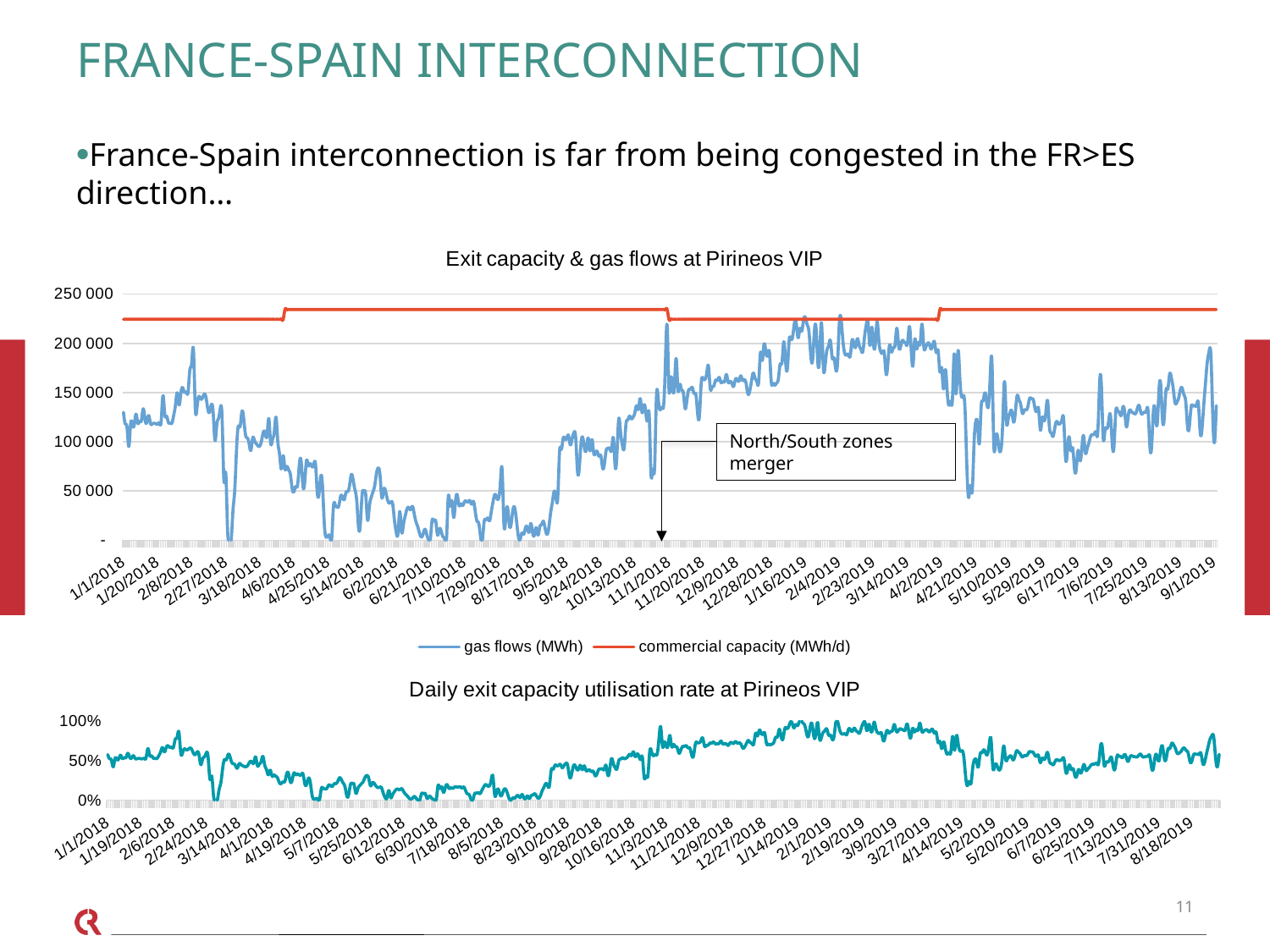
In the top chart "Exit capacity & gas flows at Pirineos VIP", do the gas flows (MWh) rise or fall between 9/5/2018 and 1/16/2019? rise In the bottom chart "Daily exit capacity utilisation rate at Pirineos VIP", is the utilisation rate around 6/12/2018 greater or less than 50%? less In the top chart "Exit capacity & gas flows at Pirineos VIP", is the commercial capacity (MWh/d) greater or less than 200 000 throughout the period? greater What kind of chart is the bottom chart titled "Daily exit capacity utilisation rate at Pirineos VIP"? Line chart How many series does the legend of the top chart "Exit capacity & gas flows at Pirineos VIP" list? 2 In the top chart "Exit capacity & gas flows at Pirineos VIP", are the gas flows (MWh) around 6/21/2018 greater or less than 50 000? less What kind of chart is the top chart titled "Exit capacity & gas flows at Pirineos VIP"? Line chart What event does the annotation on the top chart "Exit capacity & gas flows at Pirineos VIP" mark? North/South zones merger In the top chart "Exit capacity & gas flows at Pirineos VIP", which series is drawn in red? commercial capacity (MWh/d) In the top chart "Exit capacity & gas flows at Pirineos VIP", which series is higher around 7/10/2018: gas flows (MWh) or commercial capacity (MWh/d)? commercial capacity (MWh/d)